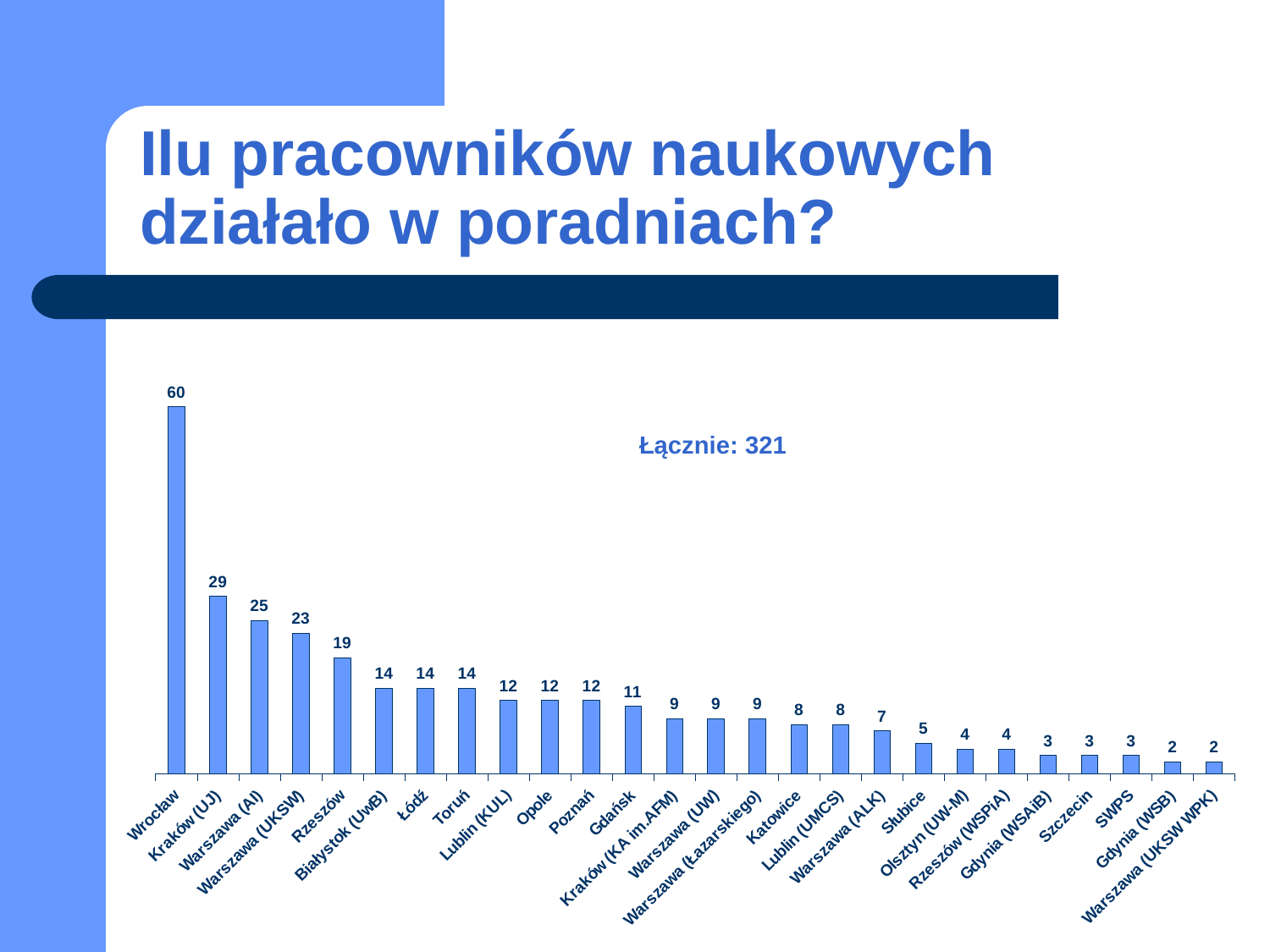
What value is shown for Kraków (UJ)? 29 Which category has the highest value? Wrocław What value is shown for Gdańsk? 11 What is the difference between the values for Wrocław and Kraków (UJ)? 31 What kind of chart is shown on the slide? bar chart How many categories are shown on the chart? 26 What total is stated in the text on the chart (Łącznie)? 321 What value is shown for Słubice? 5 Which is larger, the value for Rzeszów or the value for Białystok (UwB)? Rzeszów What value is shown for Rzeszów? 19 What is the difference between the values for Warszawa (AI) and Warszawa (UKSW)? 2 What value is shown for Wrocław? 60